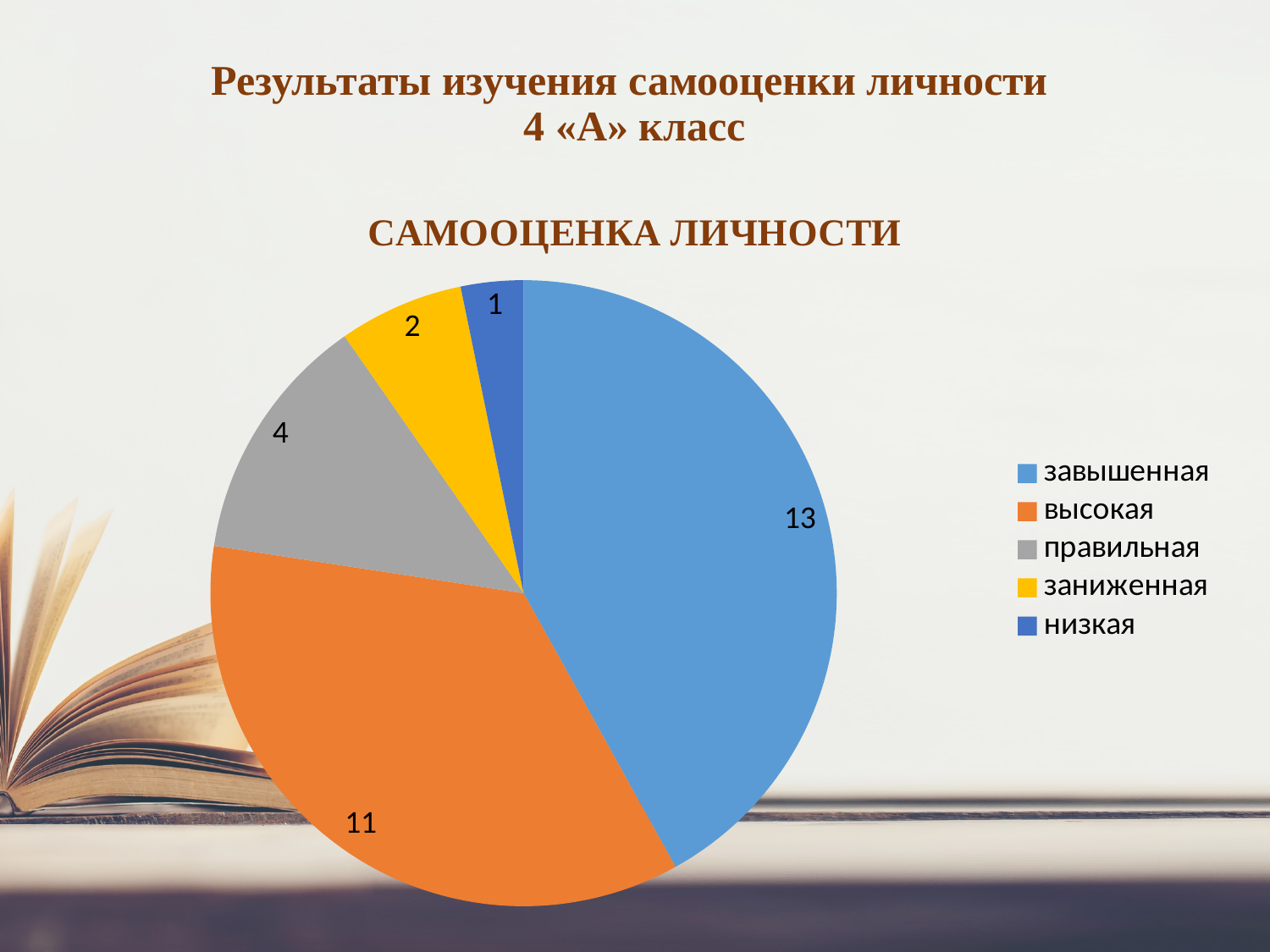
What is the value for the "низкая" slice? 1 What is the title of the chart? САМООЦЕНКА ЛИЧНОСТИ Which is larger, the value for "правильная" or the value for "заниженная"? правильная What is the value for the "завышенная" slice? 13 What is the value for the "правильная" slice? 4 What type of chart is shown on the slide? pie chart What is the value for the "высокая" slice? 11 Which category has the largest slice? завышенная How many categories does the legend list? 5 Which category has the smallest slice? низкая What is the difference between the values for "завышенная" and "высокая"? 2 What is the value for the "заниженная" slice? 2